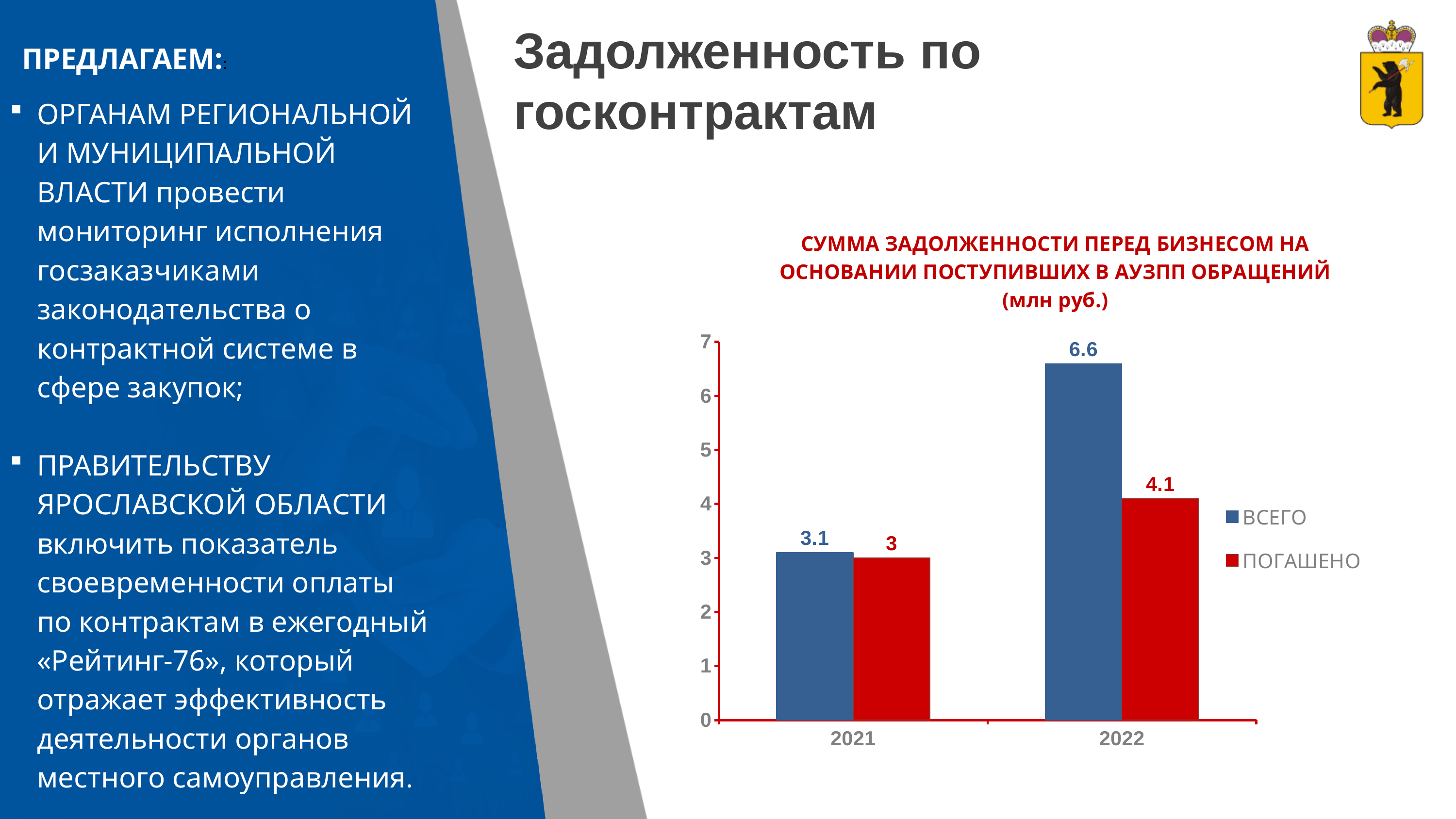
Which is larger in 2021: ВСЕГО or ПОГАШЕНО? ВСЕГО What is the difference between ВСЕГО and ПОГАШЕНО in 2022? 2.5 What is the value of ВСЕГО for 2022? 6.6 What is the value of ПОГАШЕНО for 2021? 3 Is the value of ВСЕГО for 2022 greater or less than 6? greater What is the value of ВСЕГО for 2021? 3.1 What is the value of ПОГАШЕНО for 2022? 4.1 Which year has the highest ВСЕГО value? 2022 What kind of chart is shown on the slide? bar chart Which year has the lowest ПОГАШЕНО value? 2021 How many years are shown on the x axis? 2 How many series does the legend list? 2